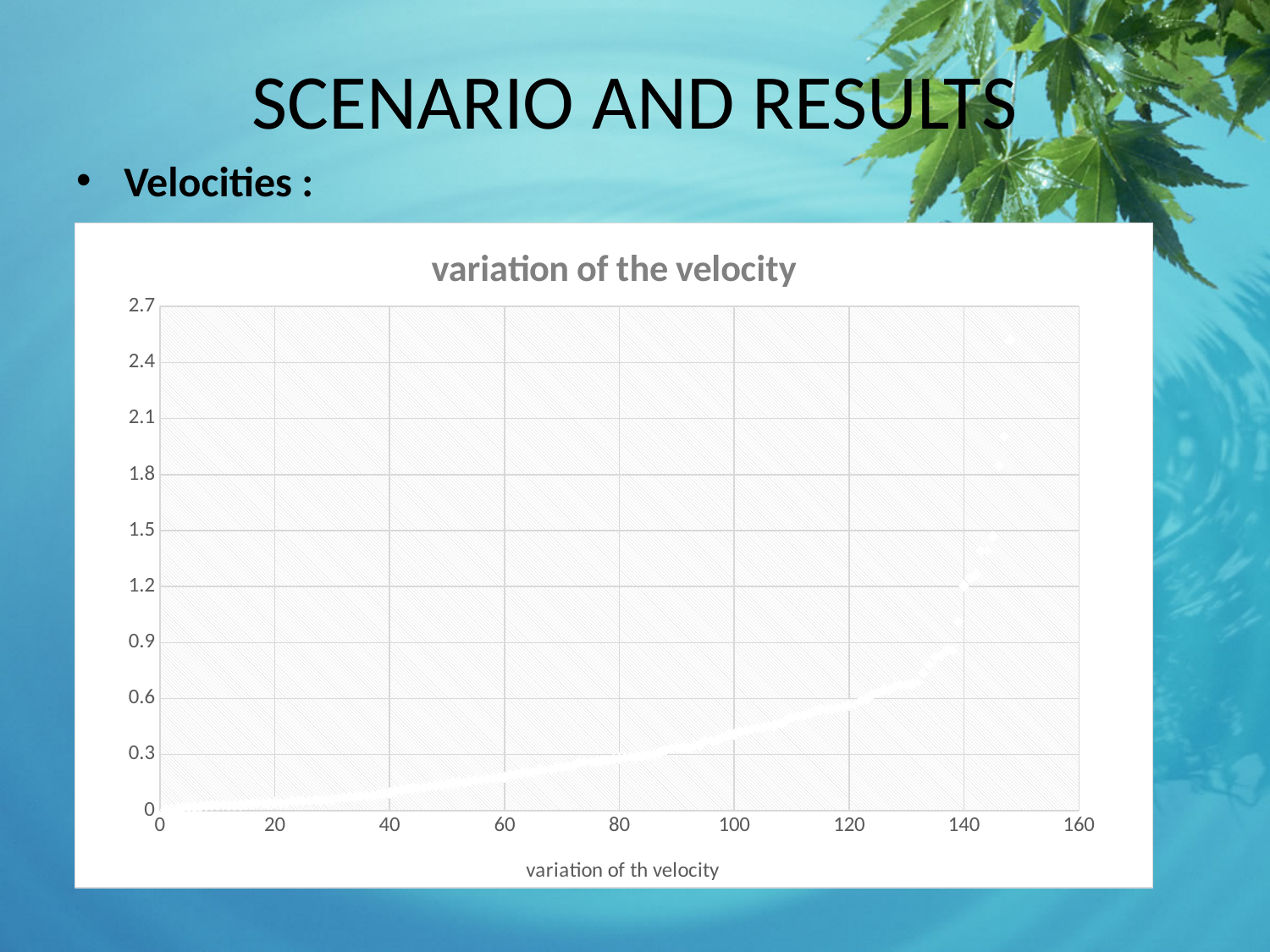
Do the plotted values rise or fall as the x-axis value increases? rise Is the plotted value at x = 60 greater or less than 0.3? less What is the highest value shown on the y-axis of the chart? 2.7 Is the plotted value at x = 100 greater or less than 0.3? greater Is the plotted value at x = 100 greater or less than 0.6? less What is the title of the chart? variation of the velocity Which has the larger plotted value, the point at x = 60 or the point at x = 120? x = 120 What kind of chart is shown on the slide? scatter chart